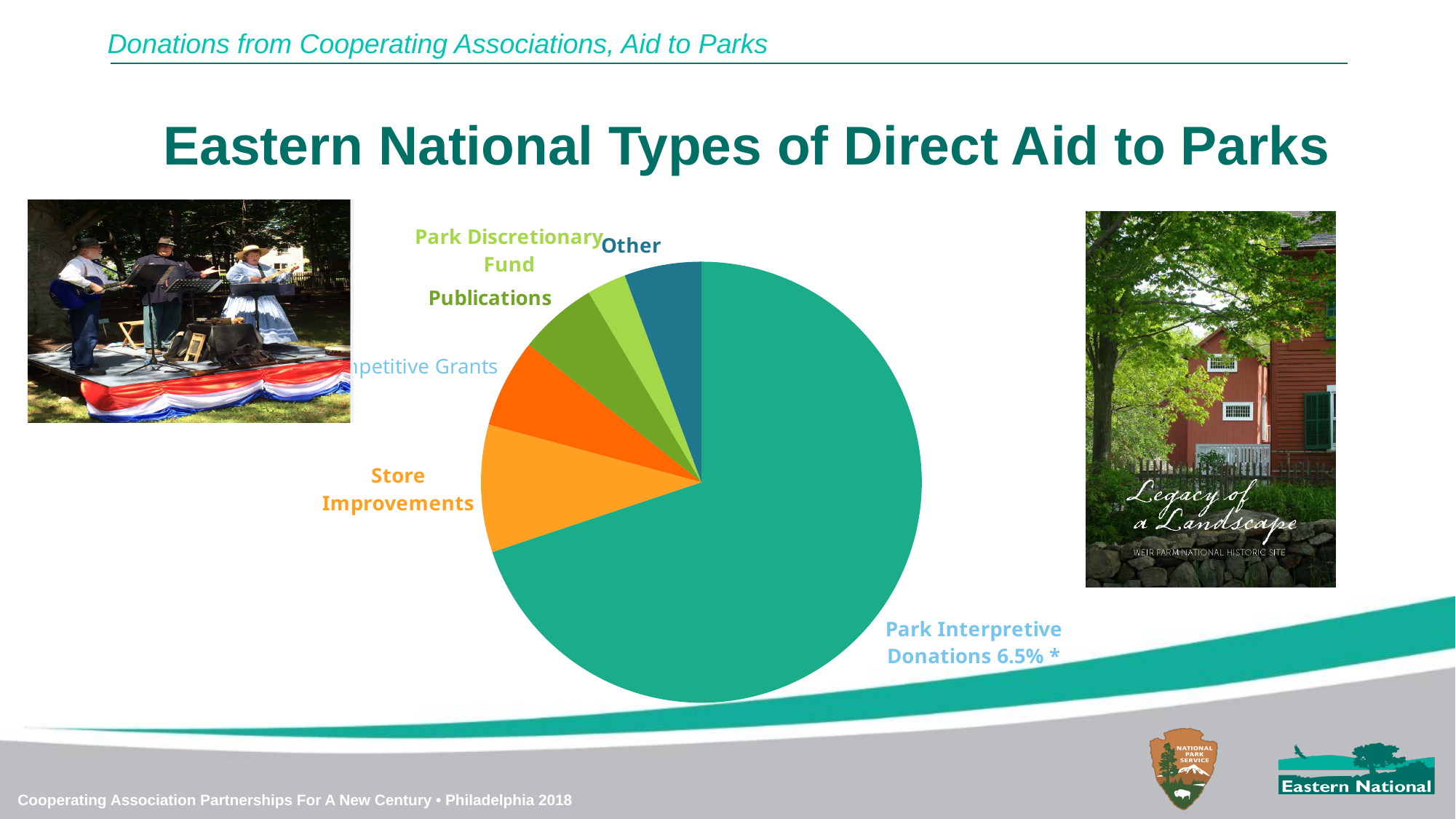
What kind of chart is shown on the slide? pie chart Which slice is larger, Publications or Park Discretionary Fund? Publications Which slice is larger, Park Interpretive Donations or Store Improvements? Park Interpretive Donations Does the Park Interpretive Donations slice take up more or less than half of the pie? more than half Which category has the largest slice of the pie chart? Park Interpretive Donations Which slice is larger, Store Improvements or Publications? Store Improvements What is the title of the chart on the slide? Eastern National Types of Direct Aid to Parks How many slices does the pie chart have? 6 What colour is the largest slice of the pie chart? teal green